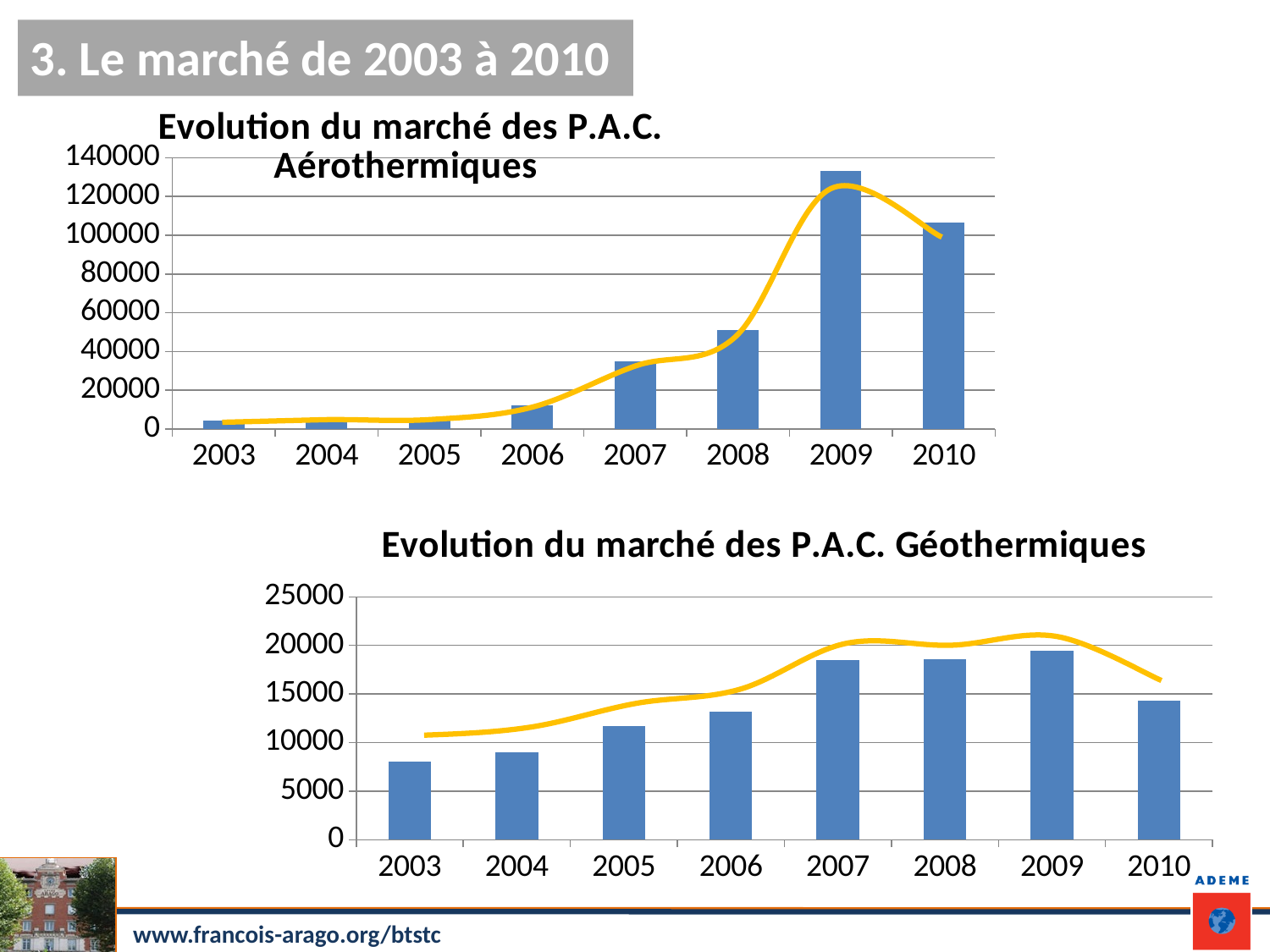
In the 'Evolution du marché des P.A.C. Géothermiques' chart, is the value for 2010 greater or less than 15000? less What kind of chart is the 'Evolution du marché des P.A.C. Aérothermiques' chart? bar chart In the 'Evolution du marché des P.A.C. Aérothermiques' chart, which year has the highest value? 2009 In the 'Evolution du marché des P.A.C. Géothermiques' chart, do the values rise or fall from 2003 to 2007? rise In the 'Evolution du marché des P.A.C. Aérothermiques' chart, is the value for 2007 greater or less than 40000? less In the 'Evolution du marché des P.A.C. Géothermiques' chart, is the value for 2003 greater or less than 10000? less In the 'Evolution du marché des P.A.C. Géothermiques' chart, which year has the lowest value? 2003 In the 'Evolution du marché des P.A.C. Aérothermiques' chart, how many years are shown on the x axis? 8 In the 'Evolution du marché des P.A.C. Géothermiques' chart, which is larger, the value for 2005 or the value for 2010? 2010 In the 'Evolution du marché des P.A.C. Aérothermiques' chart, which is larger, the value for 2009 or the value for 2010? 2009